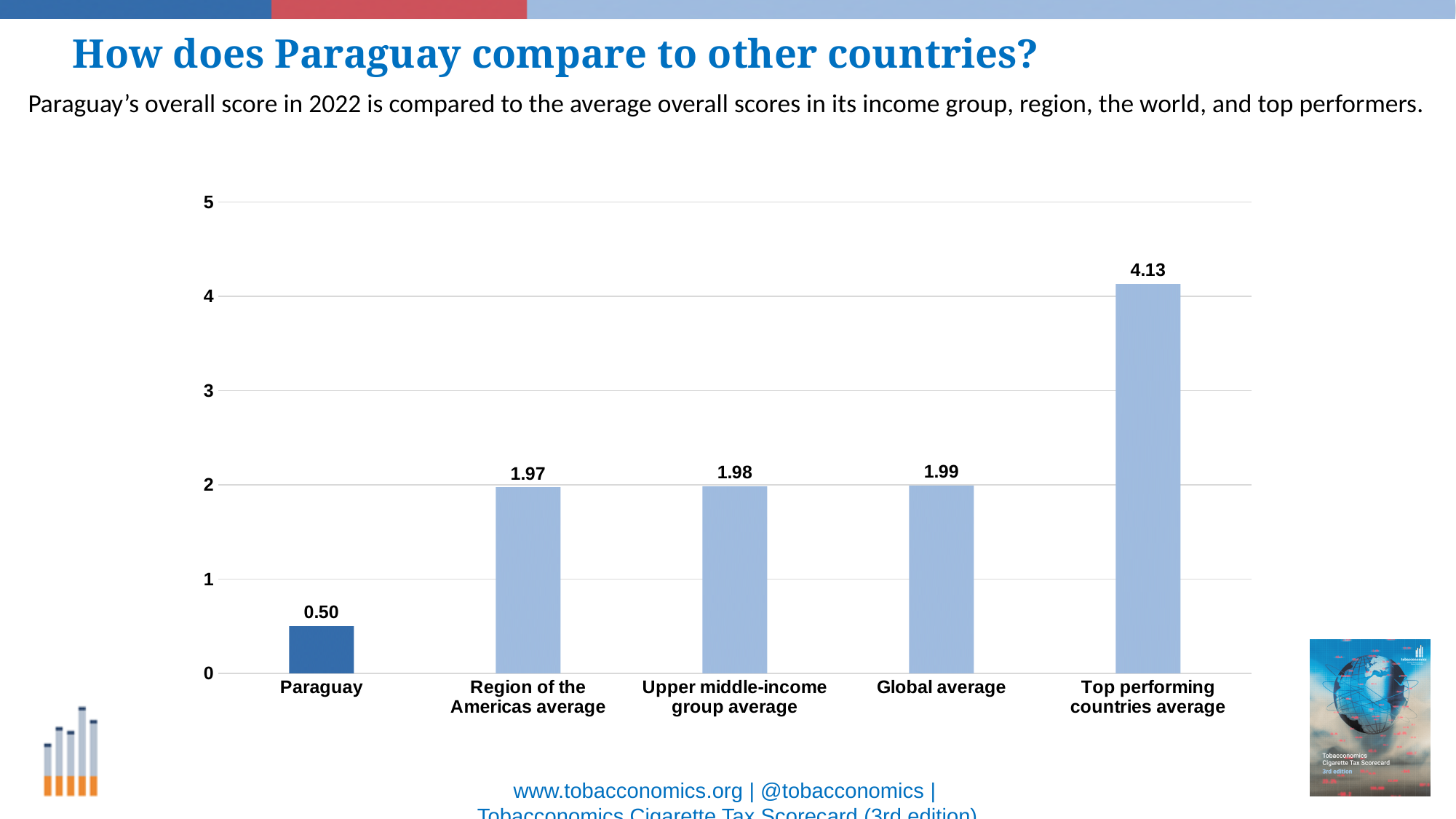
What is the value for the Global average? 1.99 Which category has the highest value? Top performing countries average Is the value for the Top performing countries average greater or less than 4? greater What kind of chart is shown on the slide? Bar chart Which is larger, the value for Paraguay or the Global average? Global average What is the difference between the Upper middle-income group average and Paraguay? 1.48 How many categories are shown on the chart? 5 What is the difference between the Top performing countries average and Paraguay? 3.63 What is the value for the Top performing countries average? 4.13 Which category has the lowest value? Paraguay What is the value for Paraguay? 0.50 What is the value for the Region of the Americas average? 1.97